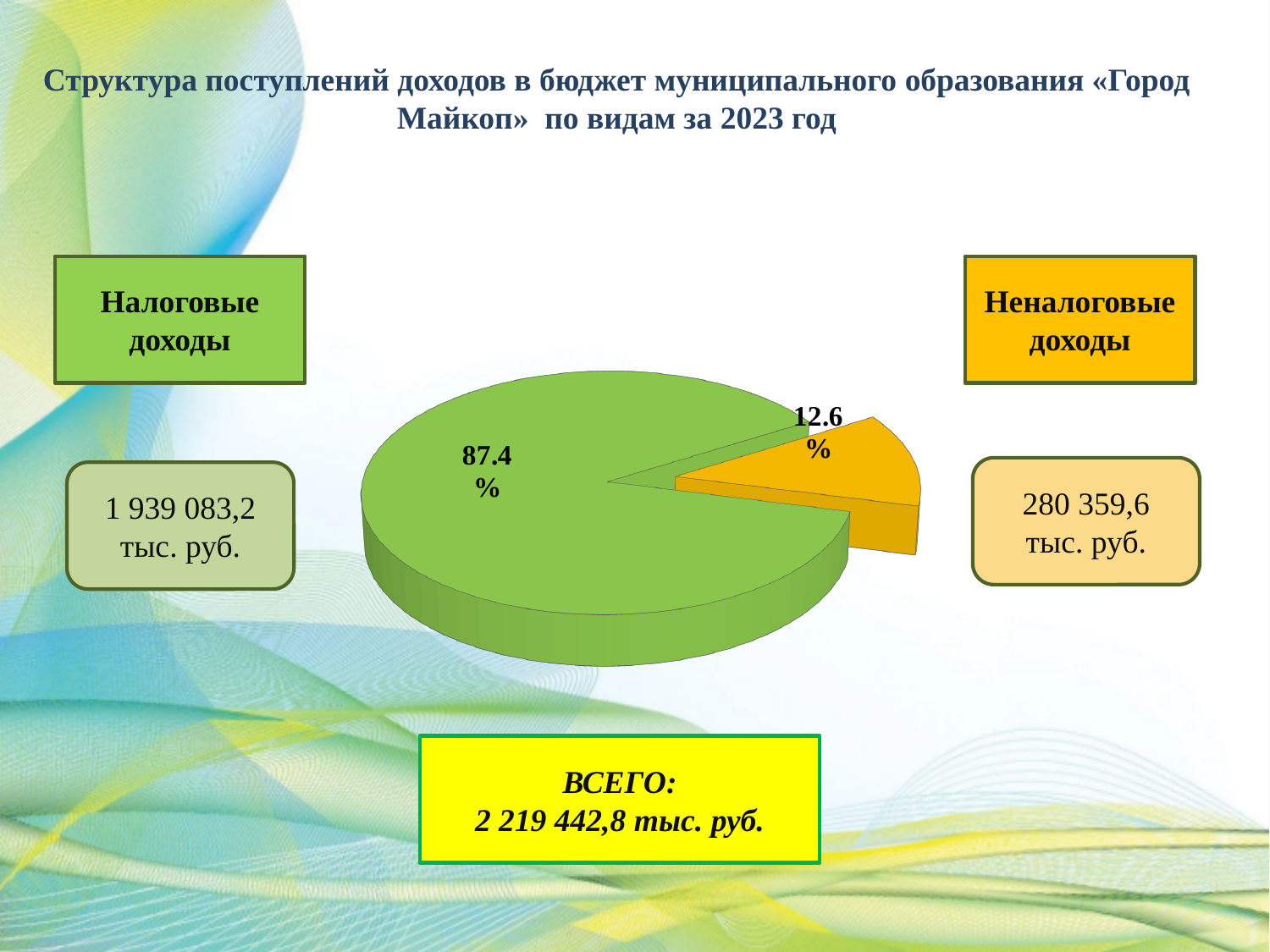
Which is larger, the share for Налоговые доходы or the share for Неналоговые доходы? Налоговые доходы What kind of chart is shown on the slide? pie chart Which category has the smallest slice of the pie? Неналоговые доходы How many slices does the pie chart have? 2 What is the difference in percentage points between the Налоговые доходы share and the Неналоговые доходы share? 74.8 What total (ВСЕГО) is shown on the slide? 2 219 442,8 тыс. руб. What share of the pie does Налоговые доходы take? 87.4% What colour is the slice for Неналоговые доходы? orange What share of the pie does Неналоговые доходы take? 12.6% Which category has the largest slice of the pie? Налоговые доходы What amount in тыс. руб. is shown for Налоговые доходы? 1 939 083,2 тыс. руб. What amount in тыс. руб. is shown for Неналоговые доходы? 280 359,6 тыс. руб.